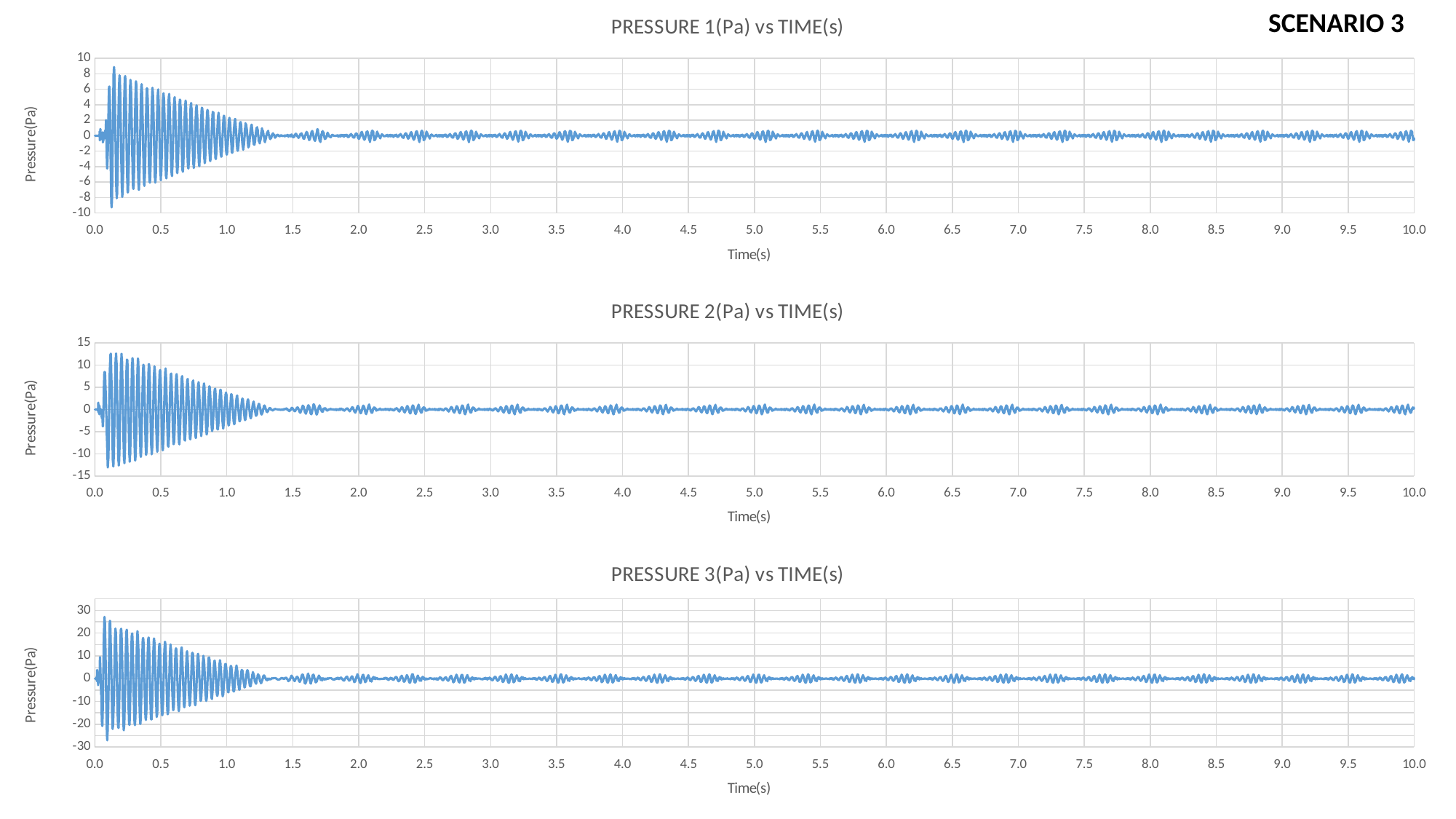
How many charts are shown on the slide? 3 What is the lowest value shown on the vertical axis of the PRESSURE 2(Pa) vs TIME(s) chart? -15 In the PRESSURE 3(Pa) vs TIME(s) chart, does the oscillation amplitude increase or decrease as time goes from 0.0 to 1.5 s? decrease What is the maximum time value shown on the horizontal axis of the PRESSURE 2(Pa) vs TIME(s) chart? 10.0 What is the highest value shown on the vertical axis of the PRESSURE 3(Pa) vs TIME(s) chart? 30 In the PRESSURE 2(Pa) vs TIME(s) chart, is the peak pressure greater or less than 10? greater What kind of chart is the PRESSURE 1(Pa) vs TIME(s) chart? line chart What is the title of the bottom chart on the slide? PRESSURE 3(Pa) vs TIME(s) In the PRESSURE 1(Pa) vs TIME(s) chart, is the pressure at time 5.0 s greater or less than 4? less Which chart reaches the larger peak pressure, PRESSURE 1(Pa) vs TIME(s) or PRESSURE 3(Pa) vs TIME(s)? PRESSURE 3(Pa) vs TIME(s) In the PRESSURE 1(Pa) vs TIME(s) chart, is the peak pressure greater or less than 5? greater